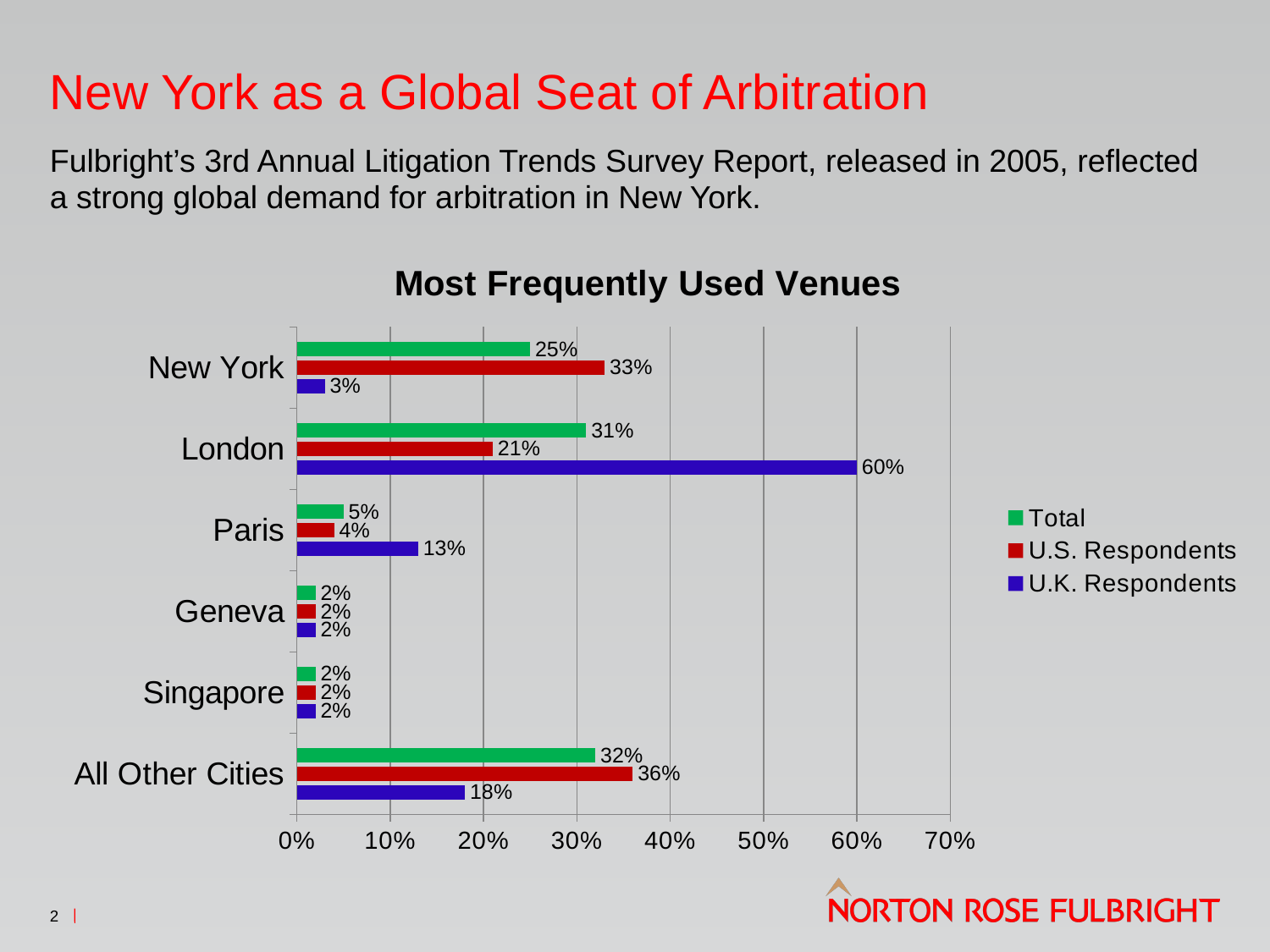
Which is larger for Paris: the U.K. Respondents value or the Total value? U.K. Respondents What is the difference between the U.S. Respondents and U.K. Respondents values for New York? 30% What is the Total value for All Other Cities? 32% Which venue has the highest U.S. Respondents value? All Other Cities What is the U.K. Respondents value for London? 60% Is the U.K. Respondents value for London greater or less than 50%? greater How many venues are shown on the chart? 6 What is the U.S. Respondents value for New York? 33% What kind of chart is shown? Bar chart What is the title of the chart? Most Frequently Used Venues How many series does the legend list? 3 Which venue has the highest U.K. Respondents value? London